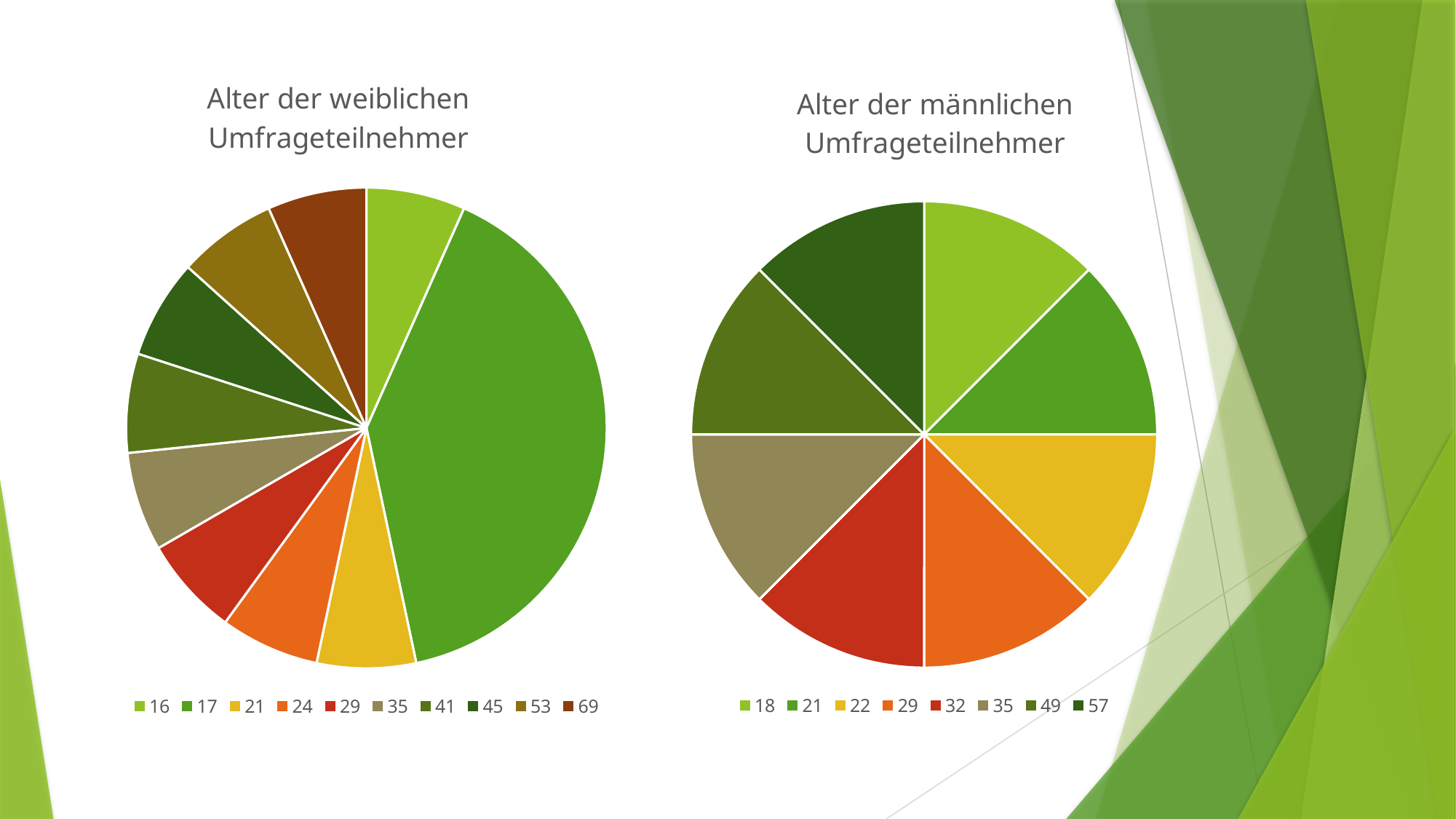
In the chart titled "Alter der weiblichen Umfrageteilnehmer", which age has the largest slice? 17 What kind of chart is the chart titled "Alter der weiblichen Umfrageteilnehmer"? pie chart In the chart titled "Alter der männlichen Umfrageteilnehmer", how many slices does the pie have? 8 In the chart titled "Alter der weiblichen Umfrageteilnehmer", which slice is larger, the one for 17 or the one for 16? 17 What kind of chart is the chart titled "Alter der männlichen Umfrageteilnehmer"? pie chart In the chart titled "Alter der weiblichen Umfrageteilnehmer", which slice is larger, the one for 17 or the one for 29? 17 What is the title of the left chart on the slide? Alter der weiblichen Umfrageteilnehmer In the chart titled "Alter der weiblichen Umfrageteilnehmer", how many entries does the legend list? 10 In the chart titled "Alter der weiblichen Umfrageteilnehmer", how many slices does the pie have? 10 What is the title of the right chart on the slide? Alter der männlichen Umfrageteilnehmer In the chart titled "Alter der männlichen Umfrageteilnehmer", how many entries does the legend list? 8